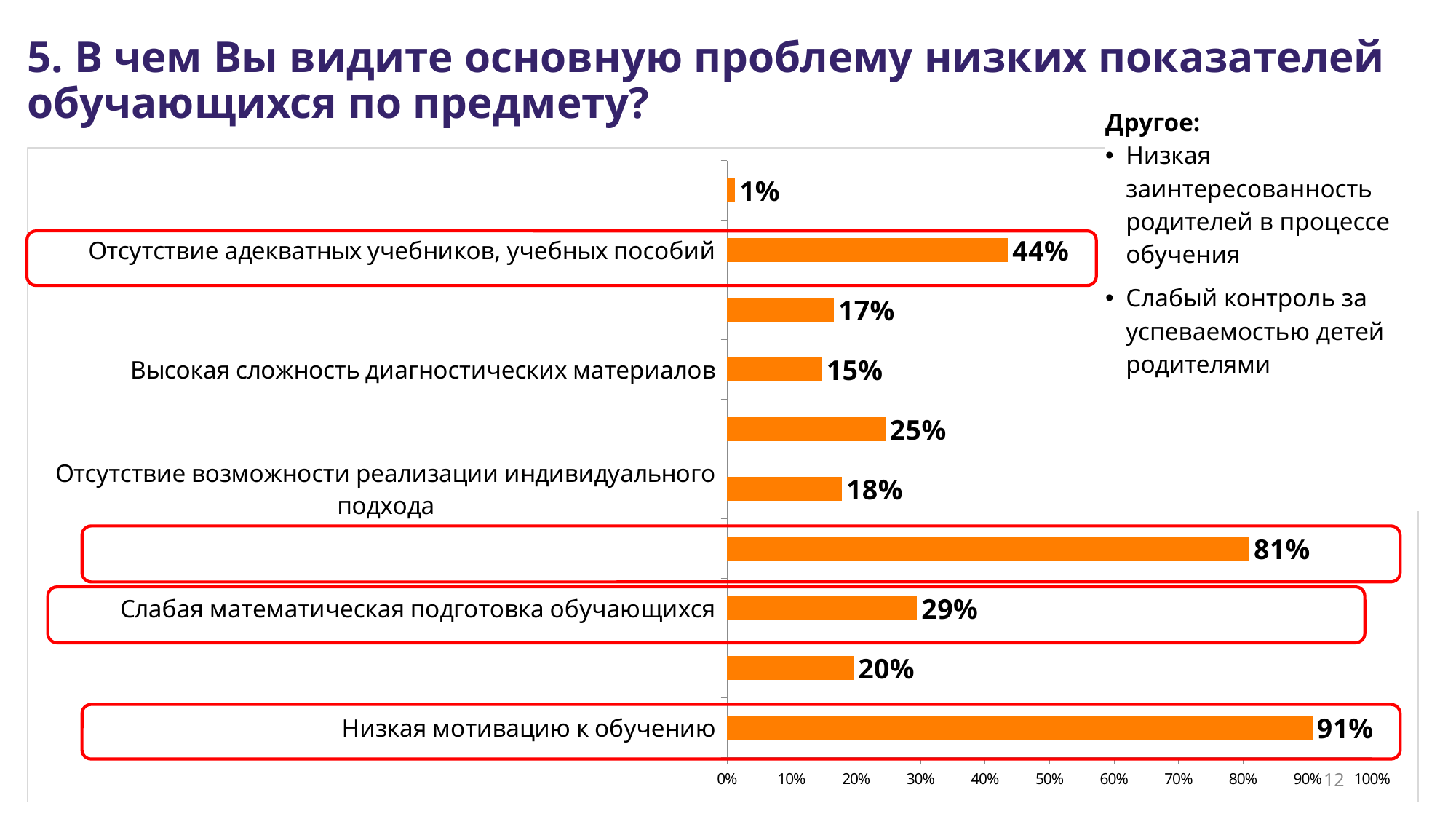
What colour are the bars in the chart? Orange What value is shown for "Отсутствие возможности реализации индивидуального подхода"? 18% What value is shown for "Отсутствие адекватных учебников, учебных пособий"? 44% What value is shown for "Низкая мотивацию к обучению"? 91% What value is shown for "Высокая сложность диагностических материалов"? 15% What is the difference between the values for "Низкая мотивацию к обучению" and "Отсутствие адекватных учебников, учебных пособий"? 47% Which is larger: the value for "Высокая сложность диагностических материалов" or for "Отсутствие возможности реализации индивидуального подхода"? Отсутствие возможности реализации индивидуального подхода What is the smallest value labelled on any bar in the chart? 1% What value is shown for "Слабая математическая подготовка обучающихся"? 29% Which labelled category has the highest value? Низкая мотивацию к обучению What kind of chart is shown on the slide? Bar chart How many bars are plotted in the chart? 10